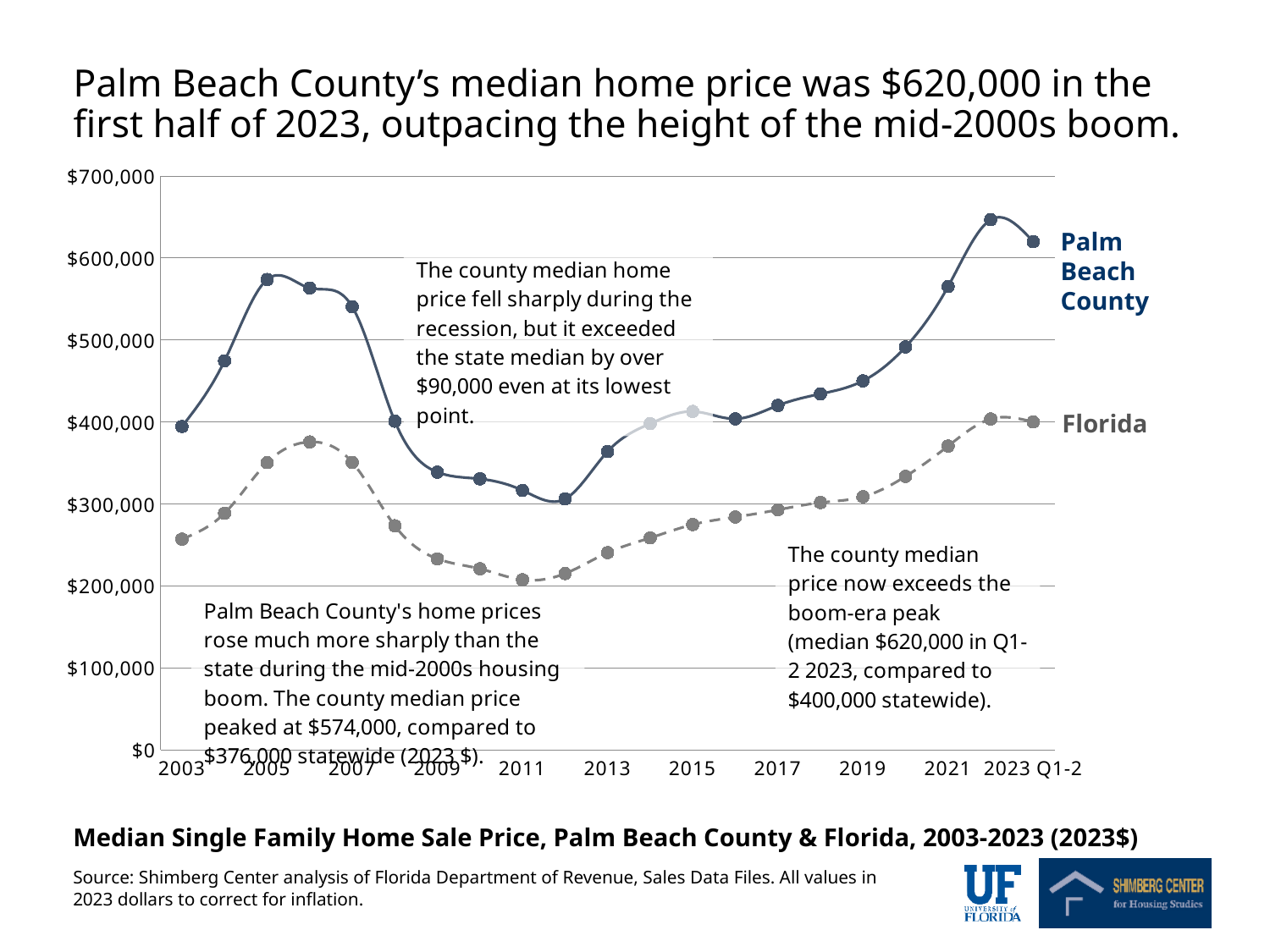
How many series are plotted on the chart? 2 How much higher was the Palm Beach County median than the Florida median in Q1-2 2023? $220,000 What kind of chart is shown on the slide? line chart What was Palm Beach County's median home price in Q1-2 2023? $620,000 What is the difference between the county's mid-2000s peak ($574,000) and the state's peak ($376,000)? $198,000 Is the Palm Beach County value for 2022 greater or less than $600,000? greater Is the Florida value for 2003 greater or less than $300,000? less Does the Palm Beach County line rise or fall between 2012 and 2022? rise In which year does the Palm Beach County line reach its highest point? 2022 What was the statewide median price peak during the mid-2000s boom? $376,000 What was the Florida statewide median home price in Q1-2 2023? $400,000 At what value did the Palm Beach County median price peak during the mid-2000s boom? $574,000